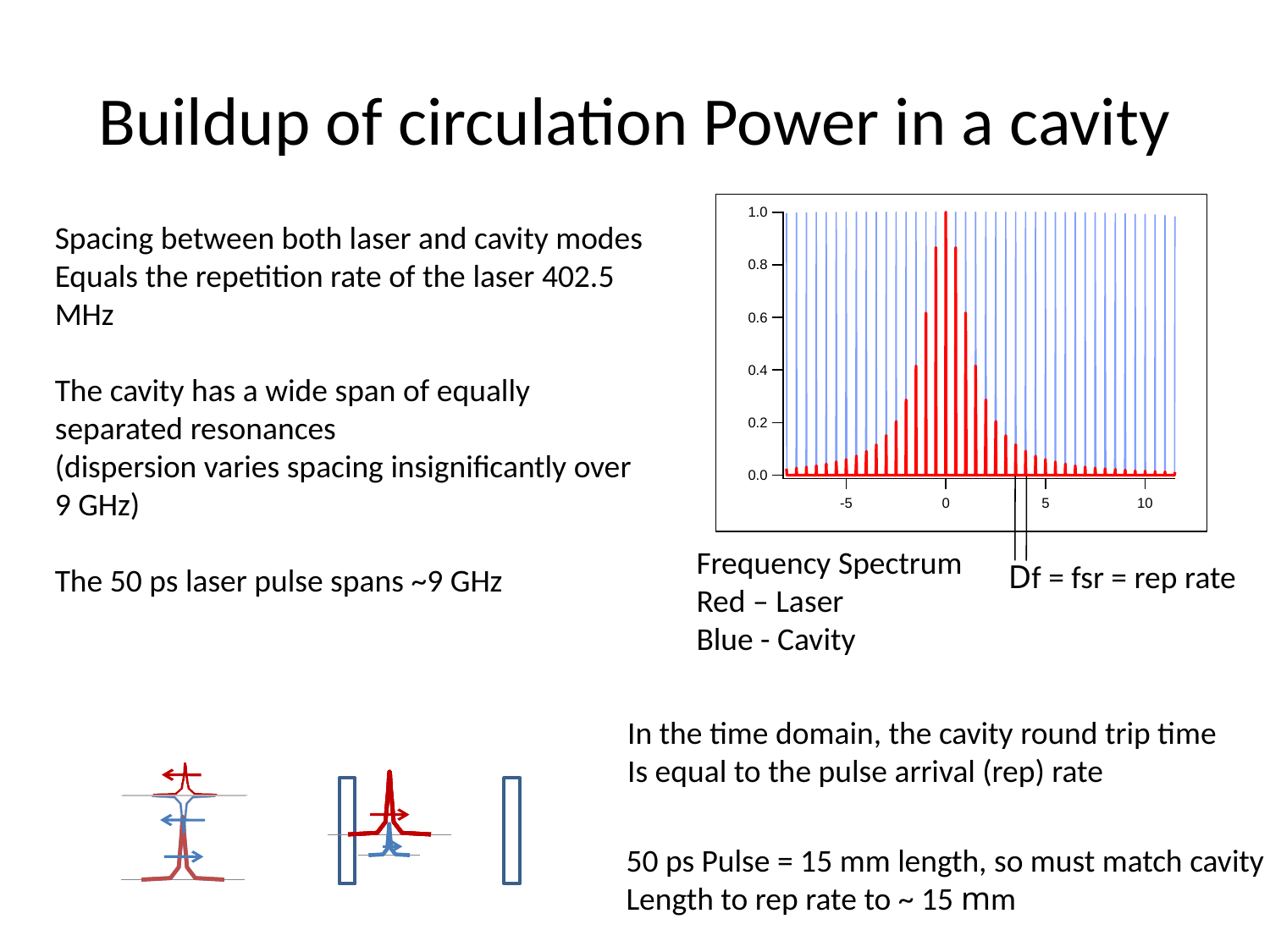
What does the blue series in the frequency spectrum chart represent? Cavity Which is larger: the red laser peak at x = 0 or the red laser peak near x = 5? The peak at x = 0 Is the tallest red laser peak (at x = 0) greater or less than 0.8? greater How many series are plotted in the frequency spectrum chart? 2 Moving from x = -5 to x = 0, do the red laser peaks rise or fall? rise Is the red laser peak near x = 5 greater or less than 0.4? less Is the red laser peak near x = 10 greater or less than 0.2? less At which x-axis value does the red laser spectrum reach its highest peak? 0 Moving from x = 0 to x = 10, do the red laser peaks rise or fall? fall What does the red series in the frequency spectrum chart represent? Laser What is the maximum value shown on the y-axis of the frequency spectrum chart? 1.0